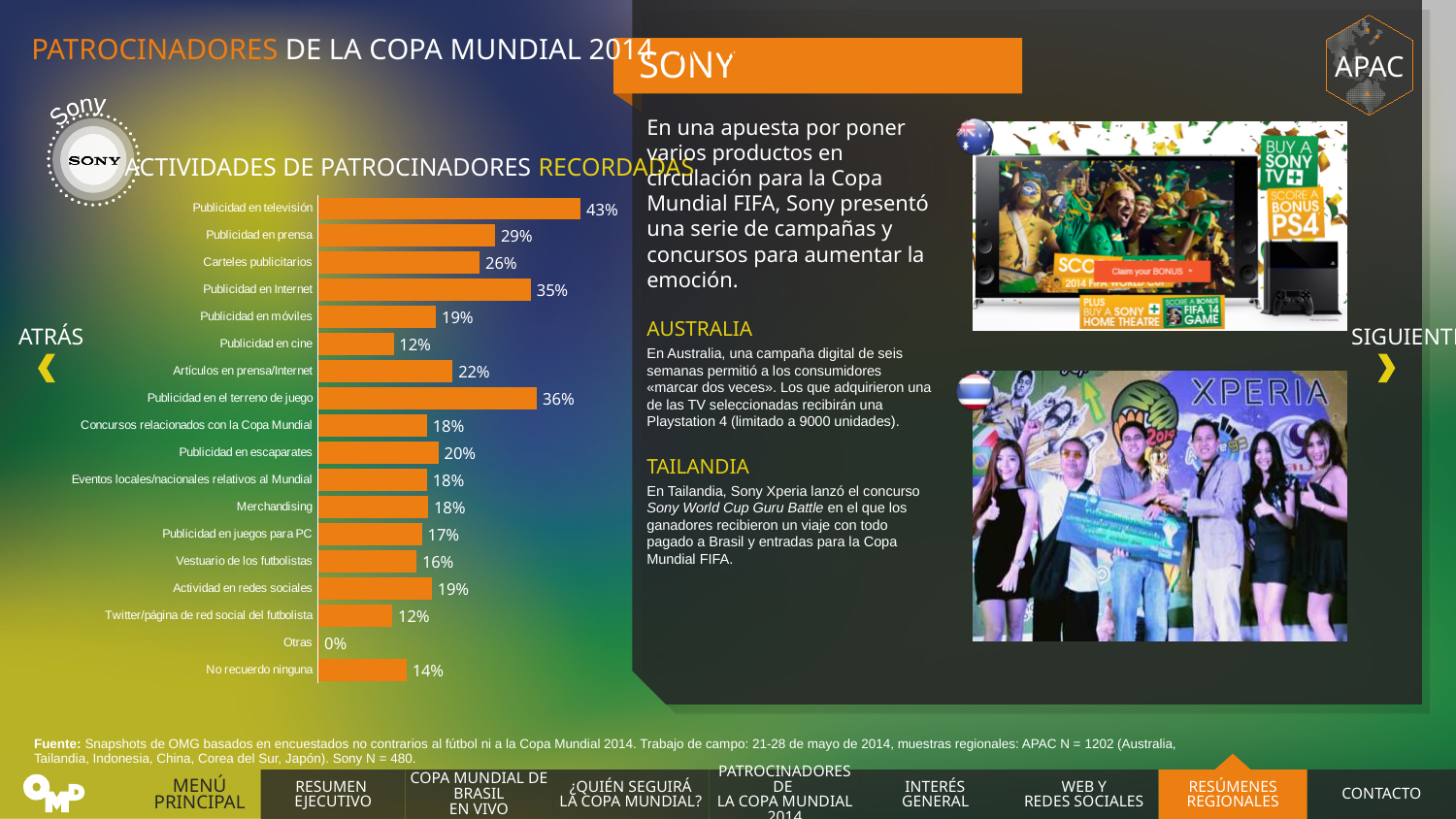
What is the title of the chart? ACTIVIDADES DE PATROCINADORES RECORDADAS What value is shown for Publicidad en el terreno de juego? 36% What value is shown for Vestuario de los futbolistas? 16% What value is shown for No recuerdo ninguna? 14% What is the difference between Publicidad en prensa and Carteles publicitarios? 3% What is the difference between Publicidad en televisión and Publicidad en Internet? 8% Which category has the highest value? Publicidad en televisión What kind of chart is shown on the slide? Bar chart How many categories are shown in the bar chart? 18 Which is larger, Publicidad en Internet or Publicidad en el terreno de juego? Publicidad en el terreno de juego What value is shown for Publicidad en televisión? 43% Which category has the lowest value? Otras